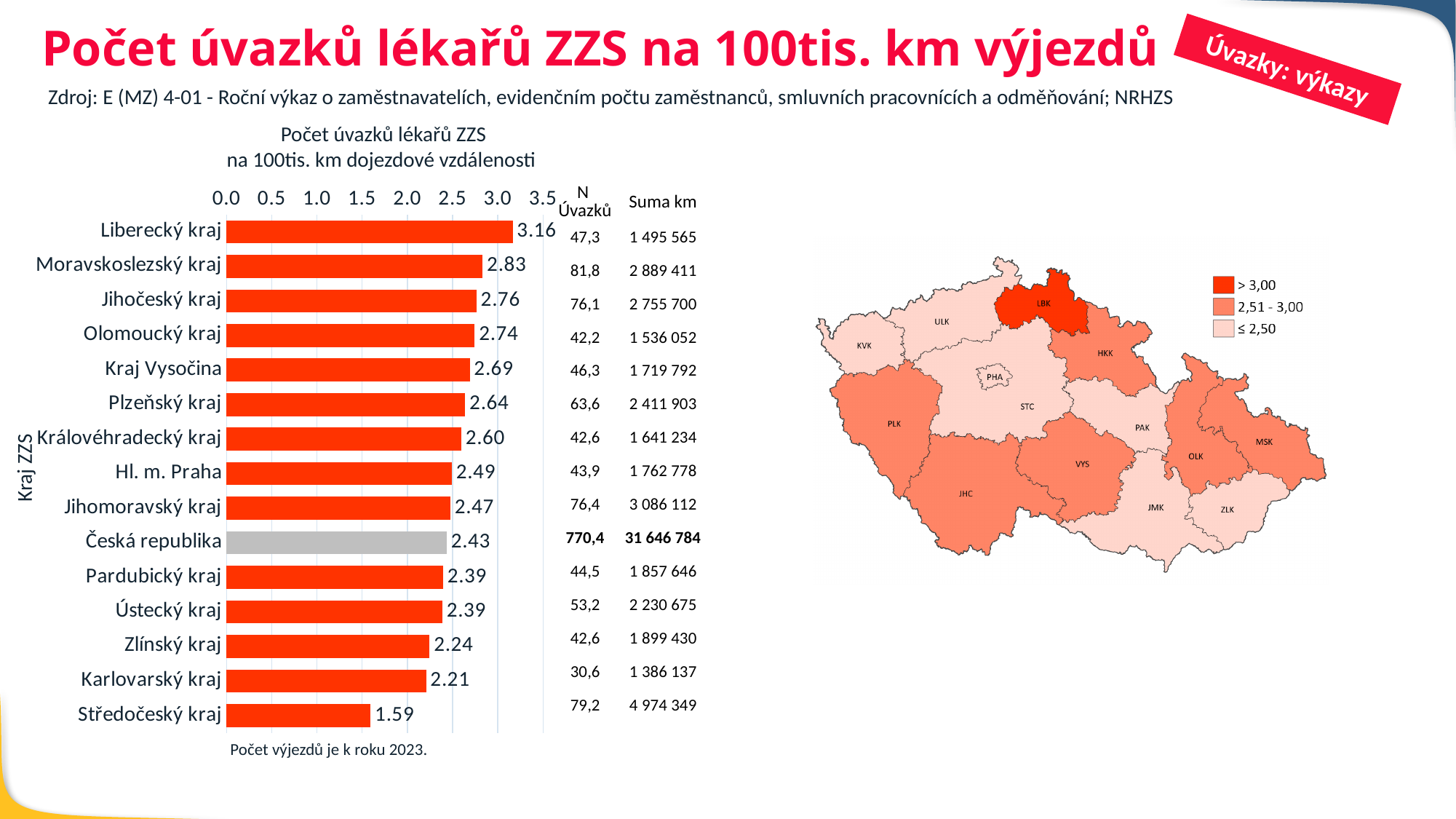
What is the value for Liberecký kraj in the bar chart? 3.16 What is the value for Středočeský kraj in the bar chart? 1.59 What is the value for Kraj Vysočina in the bar chart? 2.69 Which bar in the chart is coloured grey instead of red? Česká republika What is the difference between the values for Liberecký kraj and Středočeský kraj? 1.57 What is the value shown for Česká republika in the bar chart? 2.43 Is the value for Karlovarský kraj greater or less than 2.5? less How many bars are shown in the bar chart? 15 Which has a larger value, Moravskoslezský kraj or Jihočeský kraj? Moravskoslezský kraj What kind of chart is shown on the left of the slide? bar chart Which category has the highest value in the bar chart? Liberecký kraj Which category has the lowest value in the bar chart? Středočeský kraj